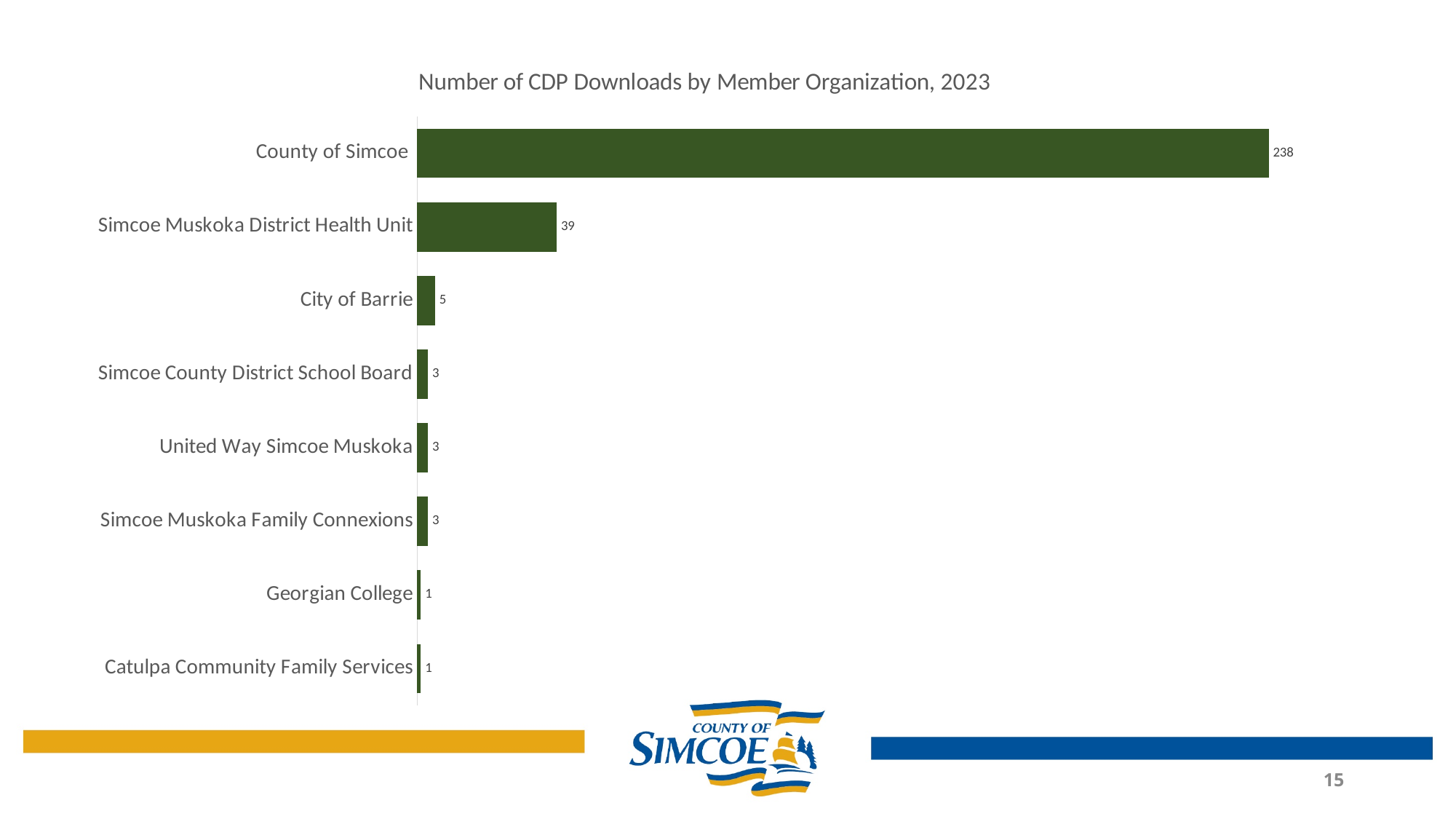
How many member organizations have exactly 3 CDP downloads? 3 Which member organization has the highest number of CDP downloads? County of Simcoe What is the difference in CDP downloads between the City of Barrie and the Simcoe County District School Board? 2 What is the difference in CDP downloads between the County of Simcoe and the Simcoe Muskoka District Health Unit? 199 What is the number of CDP downloads for the Simcoe Muskoka District Health Unit? 39 How many member organizations are shown in the chart? 8 What is the number of CDP downloads for the City of Barrie? 5 What kind of chart is shown on the slide? Bar chart Which has more CDP downloads, the Simcoe Muskoka District Health Unit or the City of Barrie? Simcoe Muskoka District Health Unit What is the number of CDP downloads for the County of Simcoe? 238 What is the title of the chart? Number of CDP Downloads by Member Organization, 2023 What is the number of CDP downloads for Georgian College? 1